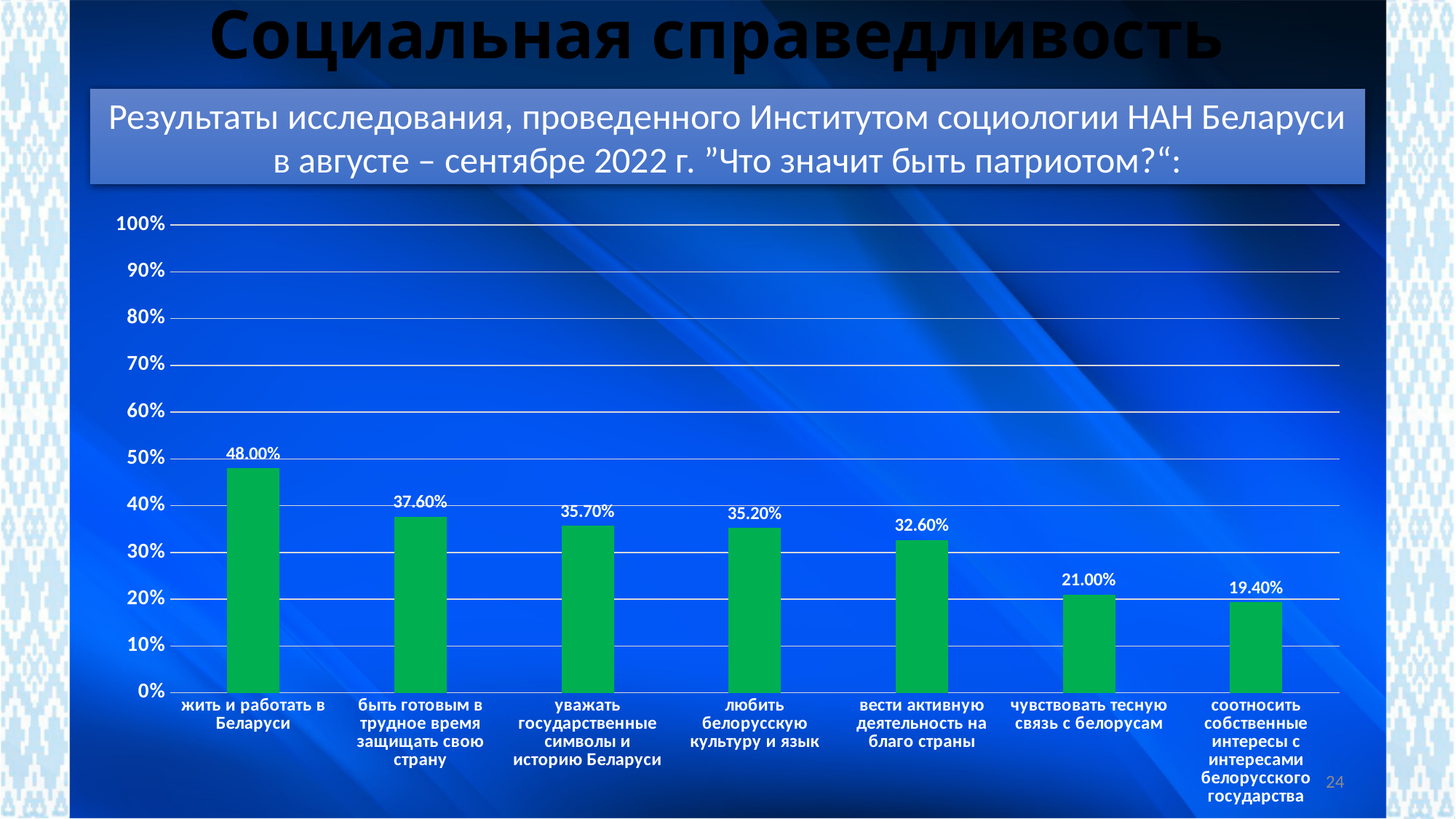
What colour are the bars in the chart? green What is the value for "жить и работать в Беларуси"? 48.00% What is the difference between the values for "жить и работать в Беларуси" and "быть готовым в трудное время защищать свою страну"? 10.40% Do the values rise or fall from left to right along the x axis? fall Which category has the lowest value? соотносить собственные интересы с интересами белорусского государства Which category has the highest value? жить и работать в Беларуси What kind of chart is shown on the slide? bar chart Is the value for "любить белорусскую культуру и язык" greater or less than 30%? greater How many categories are shown in the chart? 7 Which is larger: the value for "уважать государственные символы и историю Беларуси" or the value for "чувствовать тесную связь с белорусам"? уважать государственные символы и историю Беларуси What is the value for "вести активную деятельность на благо страны"? 32.60% What is the value for "соотносить собственные интересы с интересами белорусского государства"? 19.40%